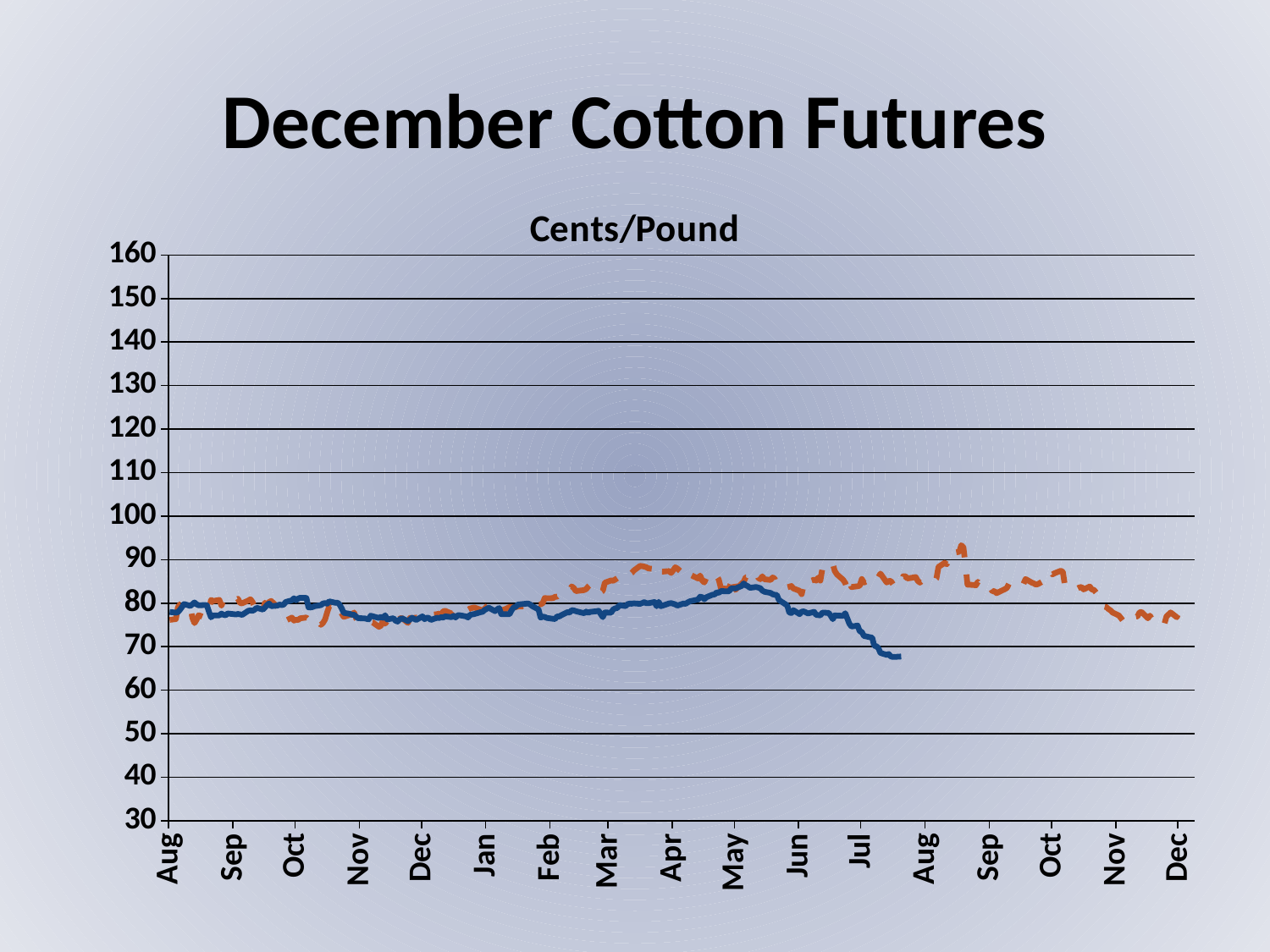
What is the title shown above the chart? Cents/Pound At Jul, which line is higher, the solid blue line or the orange dashed line? orange dashed line Is the highest point of the solid blue line greater or less than 100? less Is the final value of the solid blue line (around Jul) greater or less than 80? less Is the highest point of the orange dashed line (around Sep) greater or less than 80? greater How many lines are plotted on the chart? 2 What kind of chart is shown on the slide? line chart Does the solid blue line rise or fall between May and Jul? fall How many month labels are shown along the x axis? 17 Does the orange dashed line rise or fall between Oct and Dec at the right end of the chart? fall Which line reaches the highest point on the chart, the solid blue line or the orange dashed line? orange dashed line